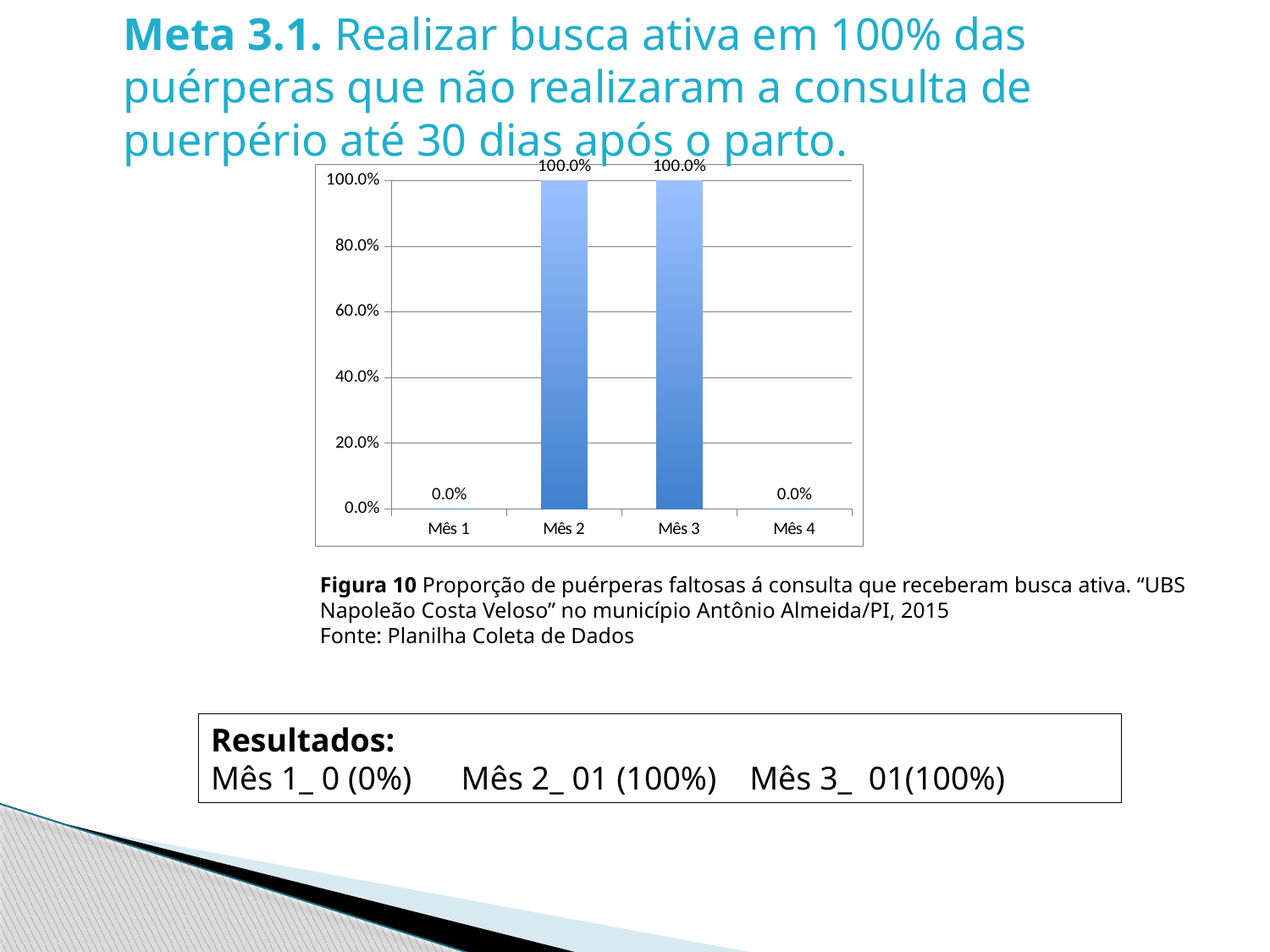
Is the value for Mês 1 greater or less than 20.0%? less How many categories are shown on the x axis of the chart? 4 Is the value for Mês 2 greater or less than 80.0%? greater What is the value for Mês 3? 100.0% What is the value for Mês 2? 100.0% What kind of chart is shown on the slide? bar chart What is the value for Mês 1? 0.0% What is the value for Mês 4? 0.0% Which is larger, the value for Mês 2 or the value for Mês 4? Mês 2 What is the highest value shown on the chart's y axis? 100.0% What is the difference between the value for Mês 3 and the value for Mês 1? 100.0% Which months have a value of 0.0% in the chart? Mês 1 and Mês 4